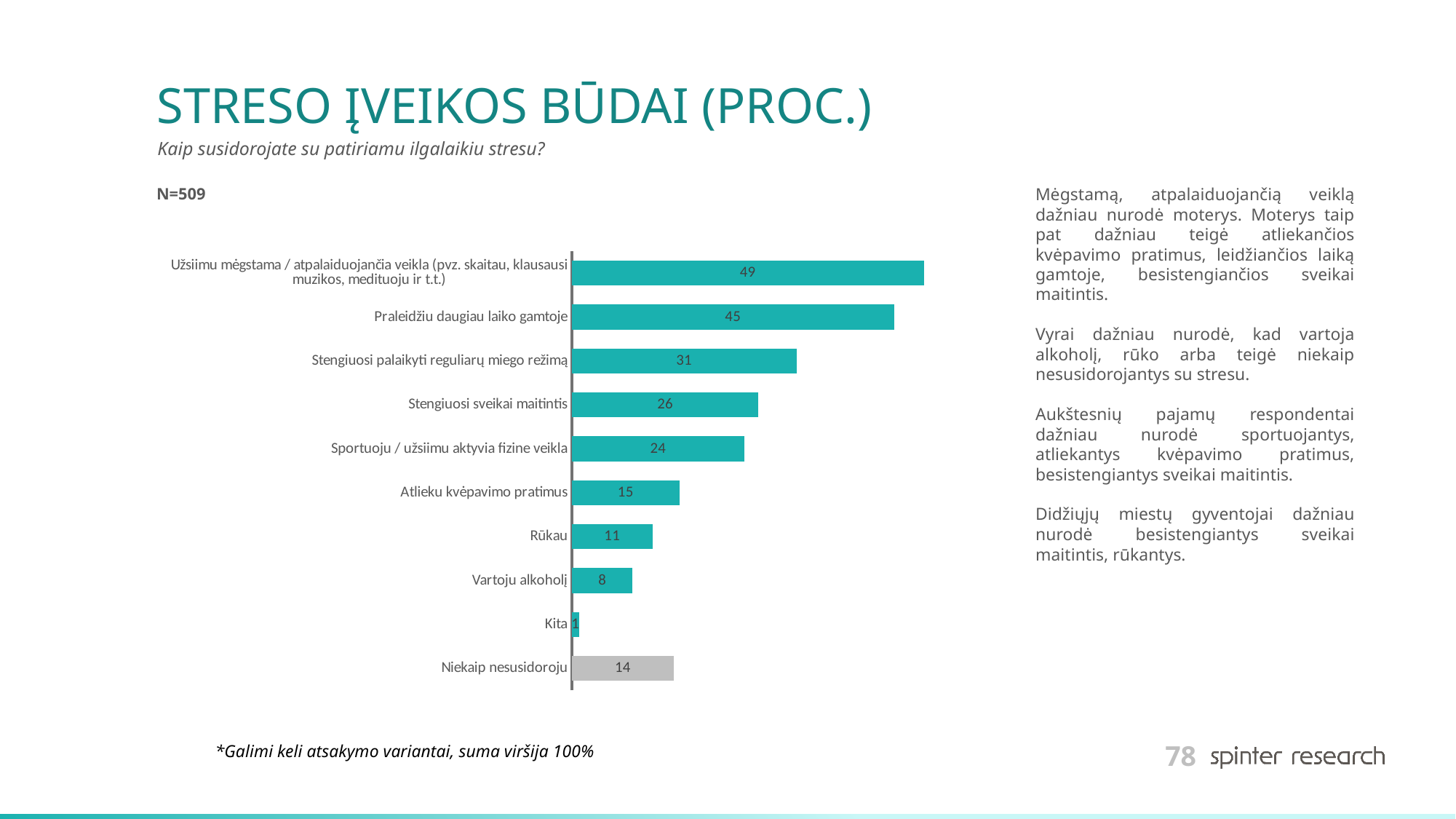
What is the value for "Praleidžiu daugiau laiko gamtoje"? 45 What is the difference between the values for "Stengiuosi palaikyti reguliarų miego režimą" and "Stengiuosi sveikai maitintis"? 5 What is the value for "Rūkau"? 11 Which bar is coloured grey instead of teal? Niekaip nesusidoroju What kind of chart is shown on the slide? Bar chart What is the difference between the values for "Sportuoju / užsiimu aktyvia fizine veikla" and "Rūkau"? 13 What is the sample size (N) shown on the slide? N=509 Which category has the lowest value? Kita What is the value for "Niekaip nesusidoroju"? 14 How many categories are shown in the chart? 10 Which category has the highest value? Užsiimu mėgstama / atpalaiduojančia veikla (pvz. skaitau, klausausi muzikos, medituoju ir t.t.) Which is larger: the value for "Atlieku kvėpavimo pratimus" or the value for "Vartoju alkoholį"? Atlieku kvėpavimo pratimus